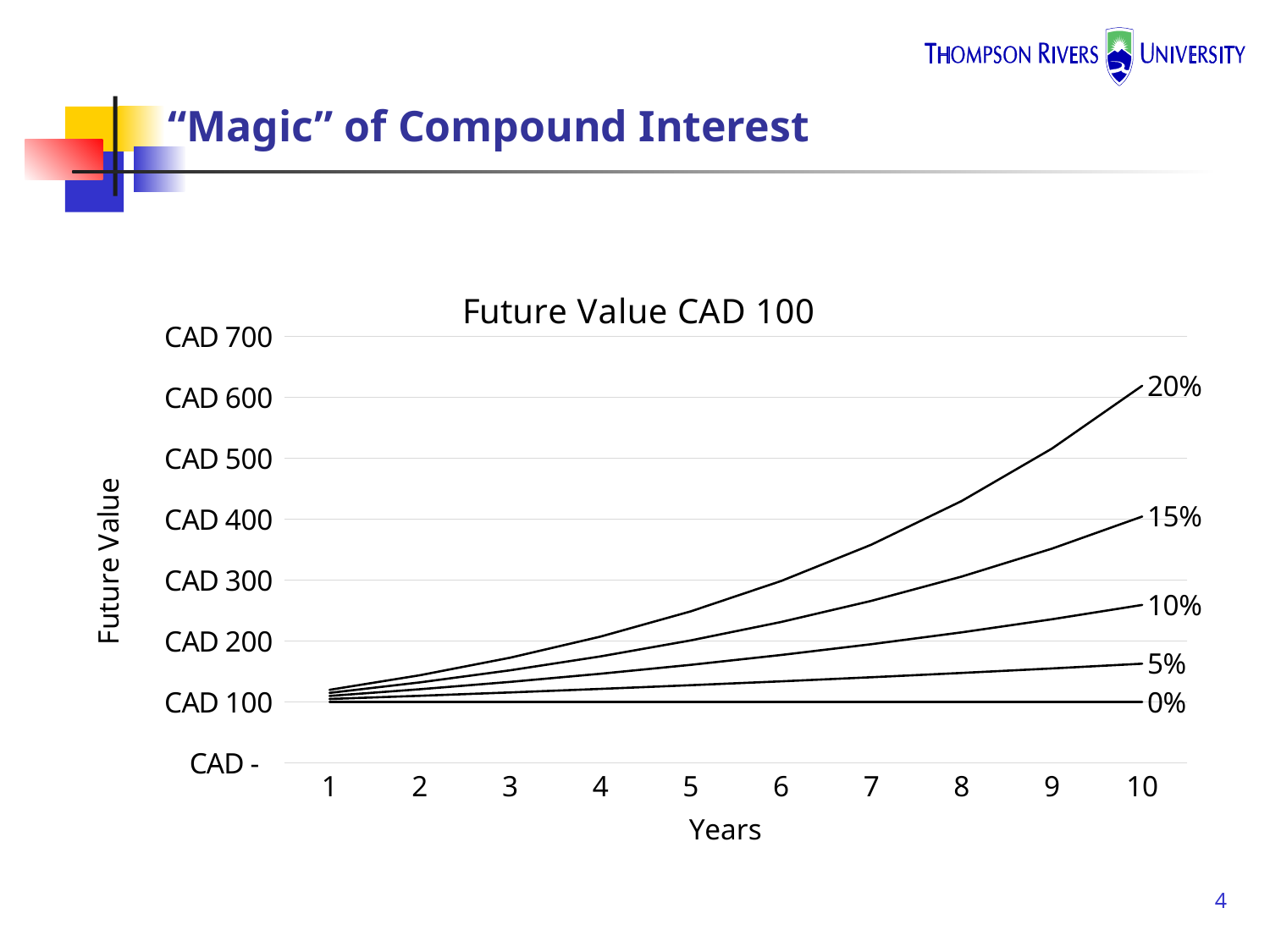
What kind of chart is shown on the slide? line chart At year 10, which is larger: the value for the 10% line or the 15% line? 15% Which interest rate line has the lowest future value at year 10? 0% How many years are shown along the x axis? 10 What is the future value for the 0% line at year 10? CAD 100 Is the value for the 20% line at year 10 greater or less than CAD 500? greater Is the value for the 5% line at year 10 greater or less than CAD 200? less How many interest-rate lines are plotted on the chart? 5 Which interest rate line reaches the highest future value at year 10? 20% Is the value for the 15% line at year 10 greater or less than CAD 300? greater What is the title of the chart? Future Value CAD 100 Does the 20% line rise or fall as the years increase? rise